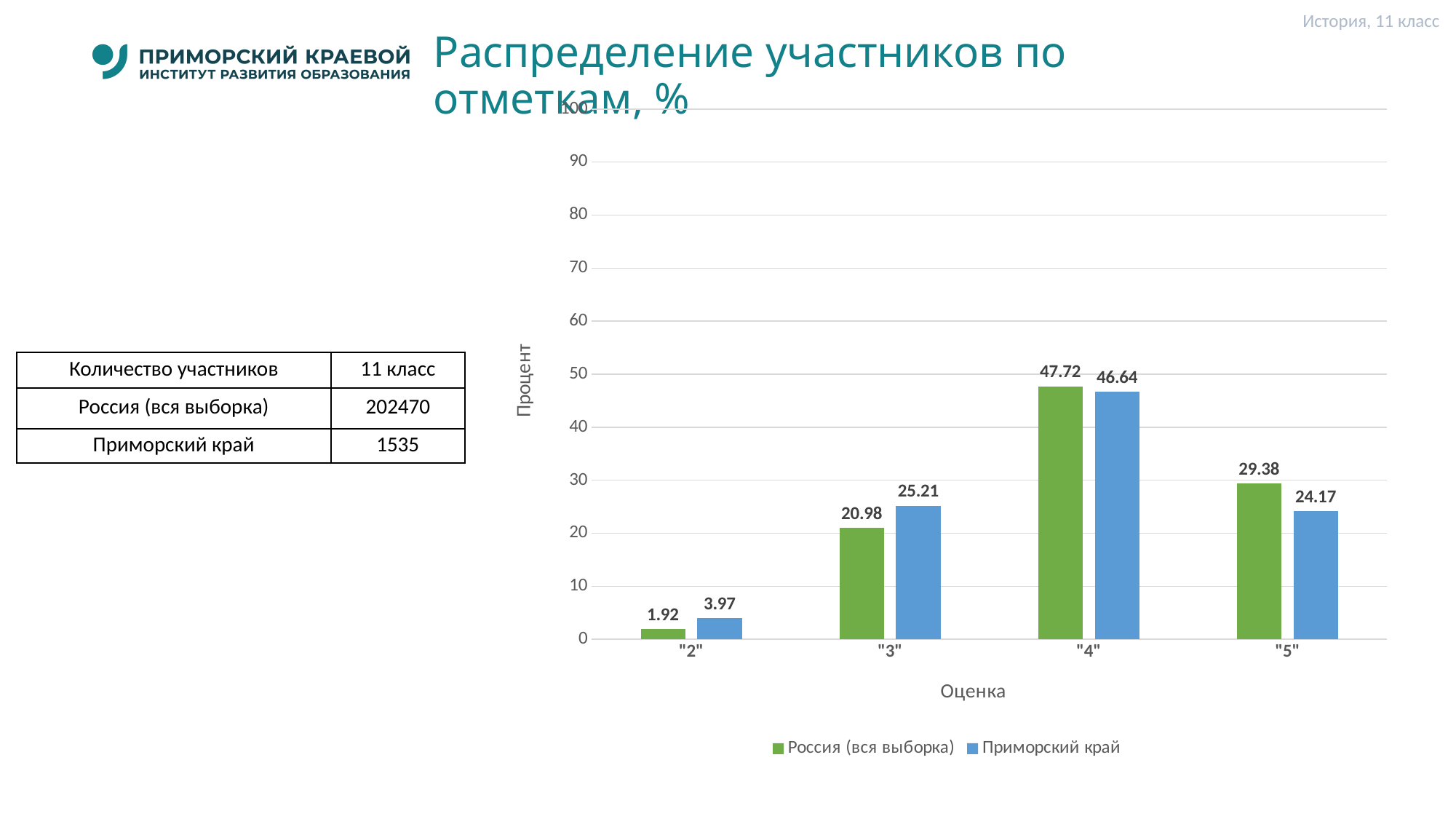
Is the value for Россия (вся выборка) at grade "5" greater or less than 20? greater How many series does the legend list? 2 Which grade has the lowest value for Россия (вся выборка)? "2" What is the difference between Приморский край and Россия (вся выборка) at grade "3"? 4.23 What is the value for Россия (вся выборка) at grade "4"? 47.72 How many grade categories are shown on the x axis? 4 What kind of chart is shown on the slide? bar chart What is the difference between Россия (вся выборка) and Приморский край at grade "5"? 5.21 Which is larger at grade "3": Россия (вся выборка) or Приморский край? Приморский край What is the value for Приморский край at grade "2"? 3.97 What is the value for Приморский край at grade "5"? 24.17 Which grade has the highest value for Приморский край? "4"